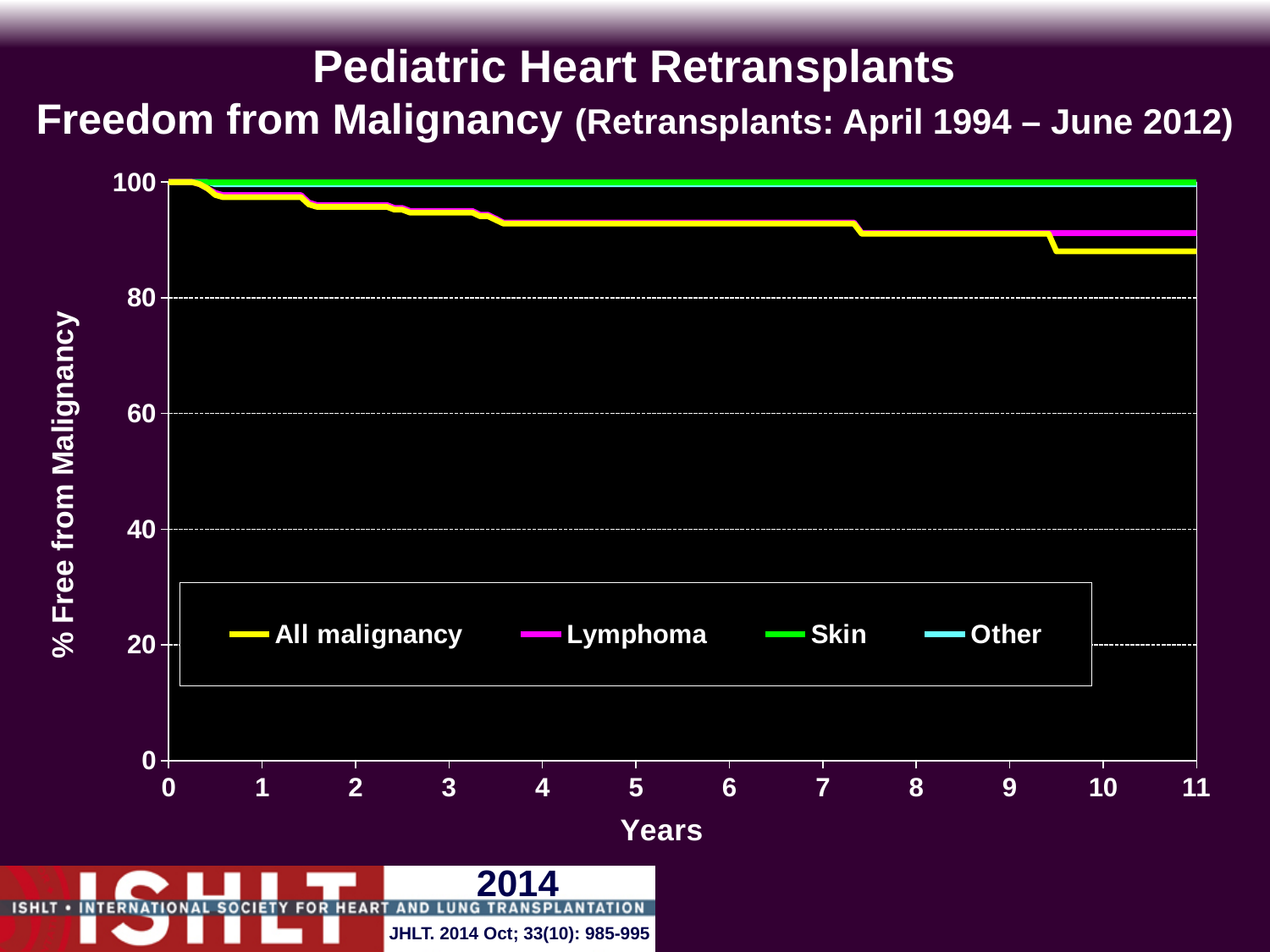
Which series has the lowest value at 11 years? All malignancy What are the series listed in the legend? All malignancy, Lymphoma, Skin, Other At 11 years, which is larger: the value for Lymphoma or the value for All malignancy? Lymphoma What is the label of the x axis? Years Is the value for Lymphoma at 5 years greater or less than 80? greater Is the value for All malignancy at 11 years greater or less than 100? less Is the value for All malignancy at 11 years greater or less than 80? greater How many series does the legend list? 4 Does the Skin line rise, fall or stay flat as years increase? stay flat What kind of chart is shown on the slide? Line chart Does the All malignancy line rise or fall as years increase? fall At 10 years, which is larger: the value for Skin or the value for All malignancy? Skin